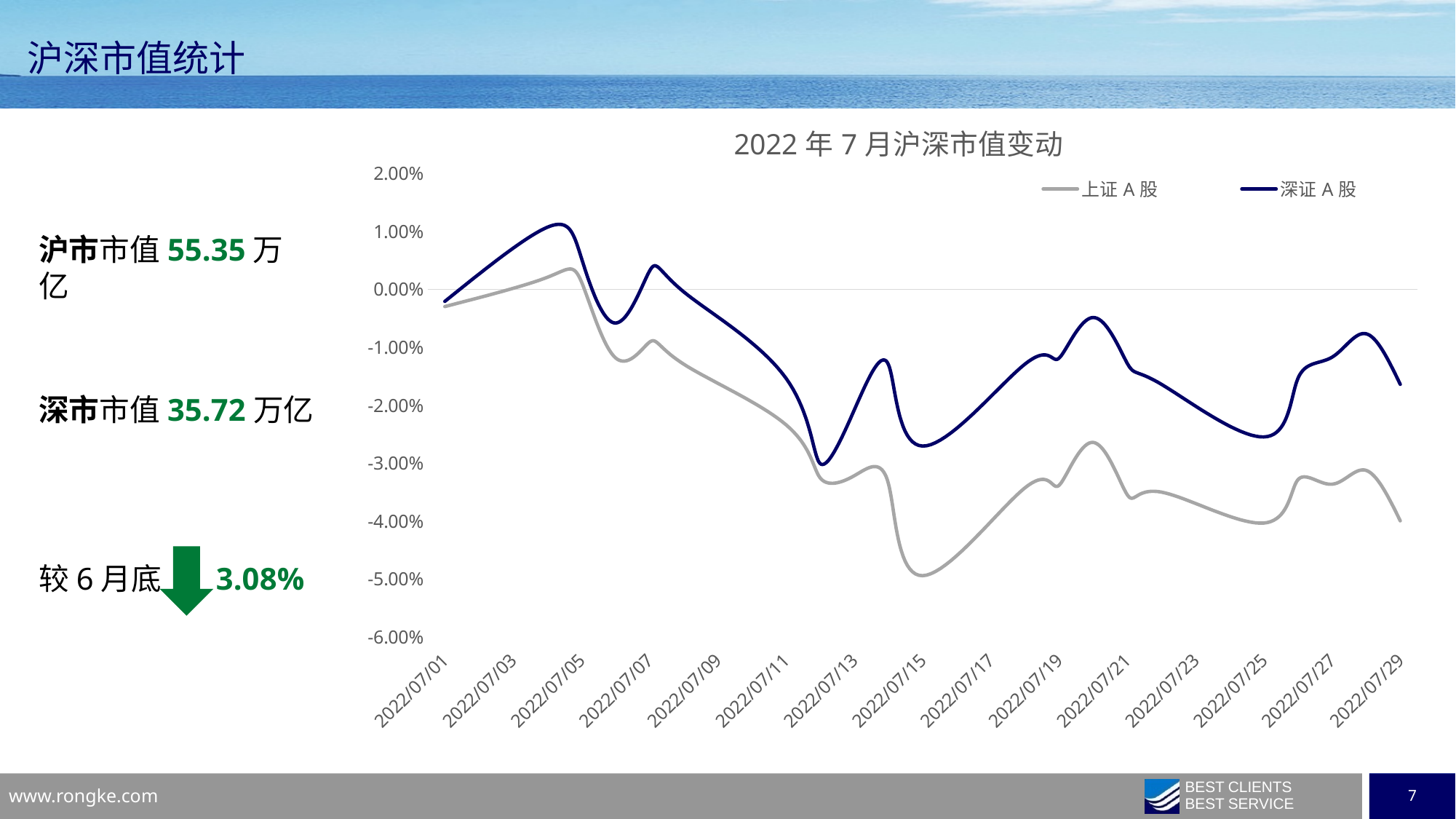
What is the lowest value shown on the chart's vertical axis? -6.00% Around which date does 上证A股 reach its lowest point in the chart? 2022/07/15 Which series is drawn in dark blue in the chart? 深证A股 Is the value for 深证A股 on 2022/07/05 greater or less than 0.00%? greater Which series has the higher value on 2022/07/15, 上证A股 or 深证A股? 深证A股 Overall, do the values for 上证A股 rise or fall from 2022/07/01 to 2022/07/29? fall What is the title of the chart? 2022年7月沪深市值变动 Is the value for 上证A股 on 2022/07/15 greater or less than -4.00%? less Is the value for 深证A股 on 2022/07/29 greater or less than -1.00%? less How many series does the chart legend list? 2 What kind of chart is shown on the slide? line chart